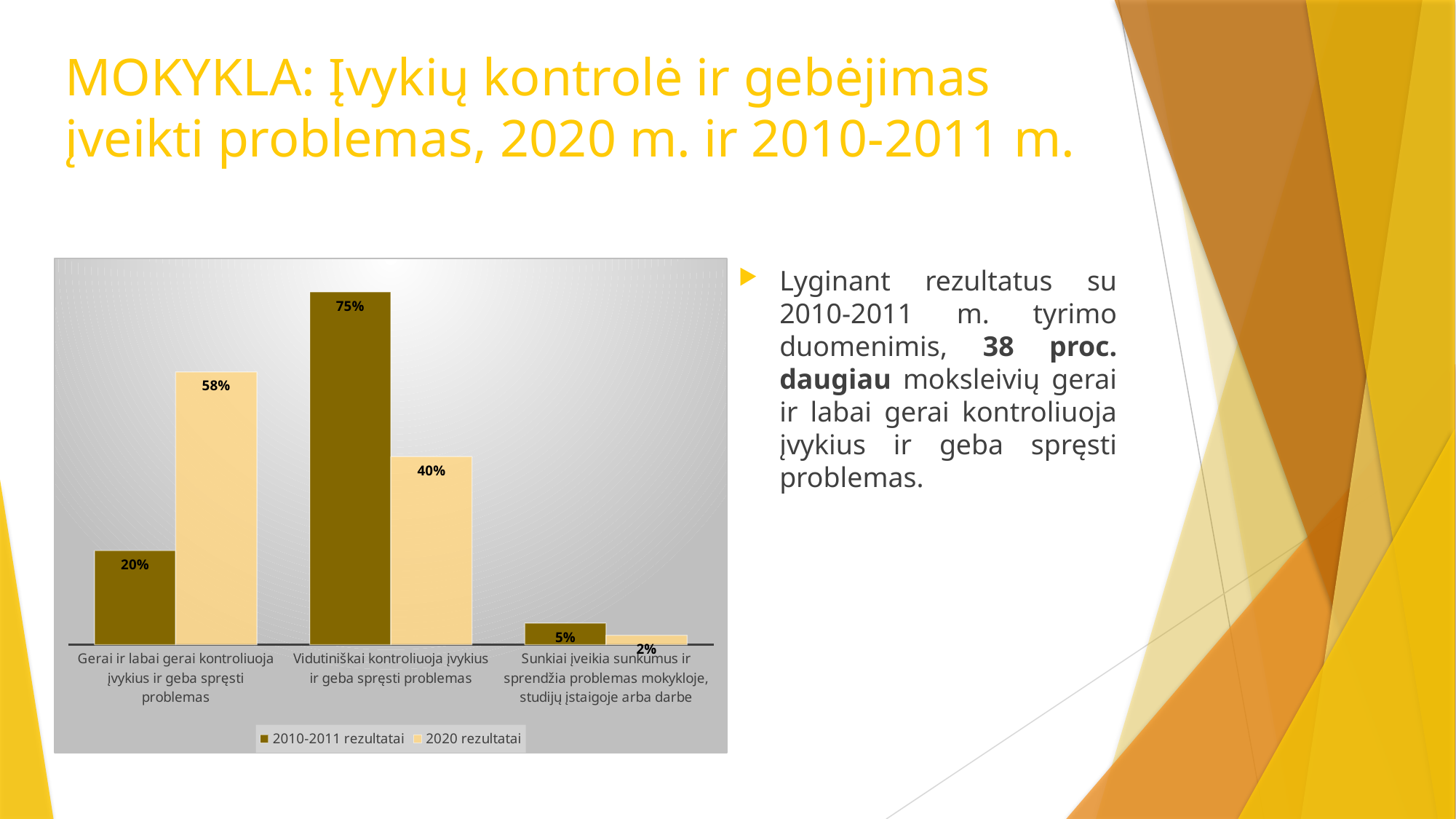
What is the 2020 rezultatai value for "Gerai ir labai gerai kontroliuoja įvykius ir geba spręsti problemas"? 58% Which category has the lowest 2020 rezultatai value? Sunkiai įveikia sunkumus ir sprendžia problemas mokykloje, studijų įstaigoje arba darbe What is the 2020 rezultatai value for "Sunkiai įveikia sunkumus ir sprendžia problemas mokykloje, studijų įstaigoje arba darbe"? 2% Which category has the highest 2010-2011 rezultatai value? Vidutiniškai kontroliuoja įvykius ir geba spręsti problemas What type of chart is shown on the slide? Bar chart How many categories are shown on the x axis of the chart? 3 What is the difference between the 2020 rezultatai and 2010-2011 rezultatai values for "Gerai ir labai gerai kontroliuoja įvykius ir geba spręsti problemas"? 38% For "Vidutiniškai kontroliuoja įvykius ir geba spręsti problemas", which series has the larger value: 2010-2011 rezultatai or 2020 rezultatai? 2010-2011 rezultatai How many series does the chart legend list? 2 What is the difference between the 2010-2011 rezultatai and 2020 rezultatai values for "Sunkiai įveikia sunkumus ir sprendžia problemas mokykloje, studijų įstaigoje arba darbe"? 3% Which legend entry is shown with the darker bars? 2010-2011 rezultatai What is the 2010-2011 rezultatai value for "Vidutiniškai kontroliuoja įvykius ir geba spręsti problemas"? 75%